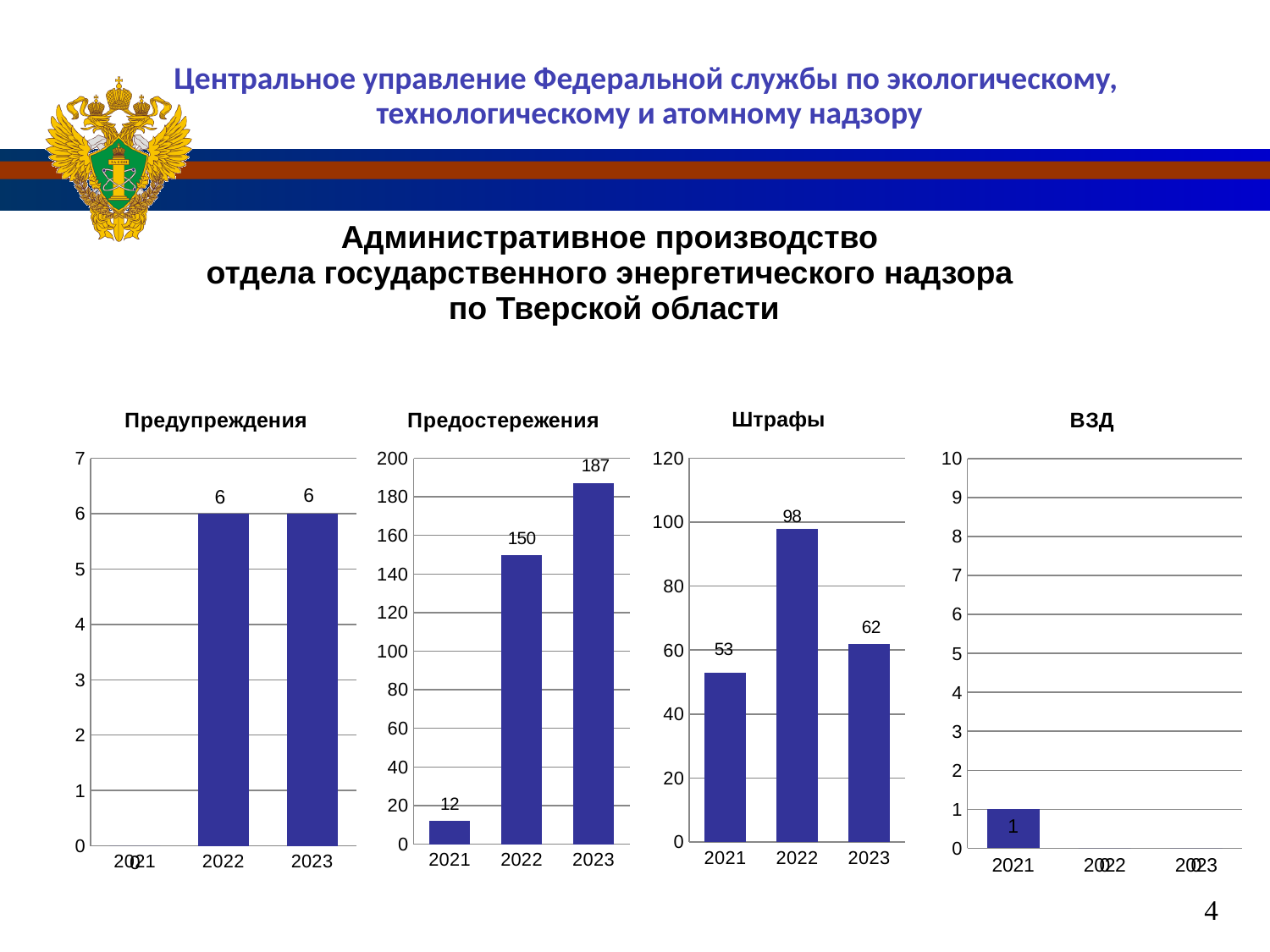
In the 'Предостережения' chart, which year has the lowest value? 2021 In the 'Предупреждения' chart, what is the value for 2022? 6 In the 'Штрафы' chart, what is the difference between the values for 2022 and 2023? 36 In the 'Предостережения' chart, do the values rise or fall from 2021 to 2023? rise In the 'Предостережения' chart, what is the value for 2023? 187 How many years are shown on the x axis of the 'Штрафы' chart? 3 In the 'Штрафы' chart, what is the value for 2021? 53 In the 'Предостережения' chart, what is the difference between the values for 2023 and 2022? 37 In the 'Штрафы' chart, which year has the highest value? 2022 What kind of chart is the 'Предостережения' chart? bar chart In the 'ВЗД' chart, what is the value for 2021? 1 In the 'Штрафы' chart, which is larger, the value for 2021 or the value for 2023? 2023